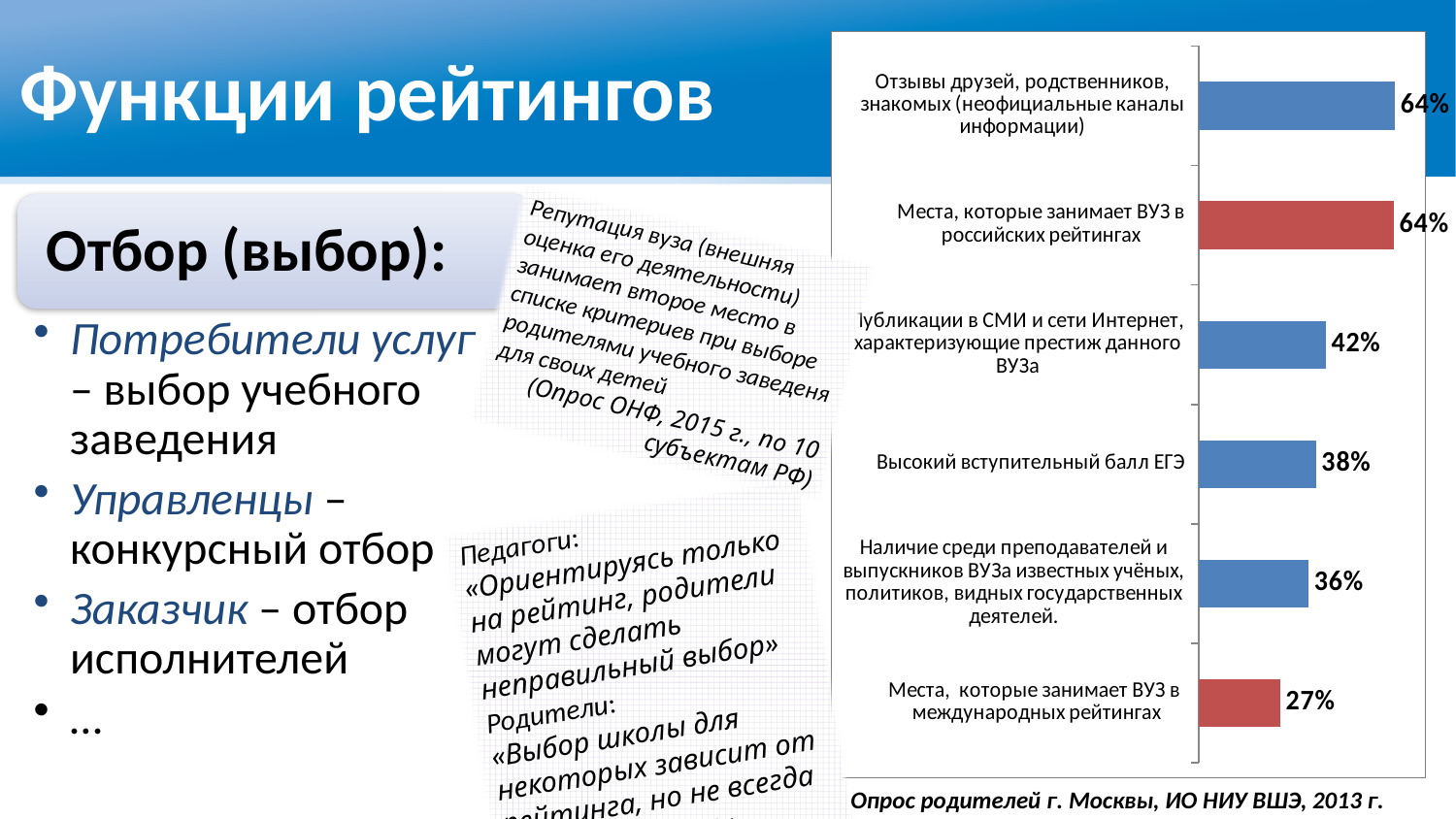
What is the value for "Наличие среди преподавателей и выпускников ВУЗа известных учёных, политиков, видных государственных деятелей"? 36% Which category has the lowest value in the chart? Места, которые занимает ВУЗ в международных рейтингах Which is larger: the value for "Высокий вступительный балл ЕГЭ" or the value for "Места, которые занимает ВУЗ в международных рейтингах"? Высокий вступительный балл ЕГЭ What is the value for "Высокий вступительный балл ЕГЭ"? 38% What is the value for "Места, которые занимает ВУЗ в международных рейтингах"? 27% What is the value for "Публикации в СМИ и сети Интернет, характеризующие престиж данного ВУЗа"? 42% What colour are the bars for the two categories about the places a university occupies in rankings? red How many categories (bars) does the chart on the right show? 6 Do the bar values increase or decrease going from the top of the chart to the bottom? decrease What is the difference between the value for "Отзывы друзей, родственников, знакомых" and the value for "Места, которые занимает ВУЗ в международных рейтингах"? 37 percentage points What kind of chart is shown on the right side of the slide? bar chart What is the value for "Места, которые занимает ВУЗ в российских рейтингах"? 64%